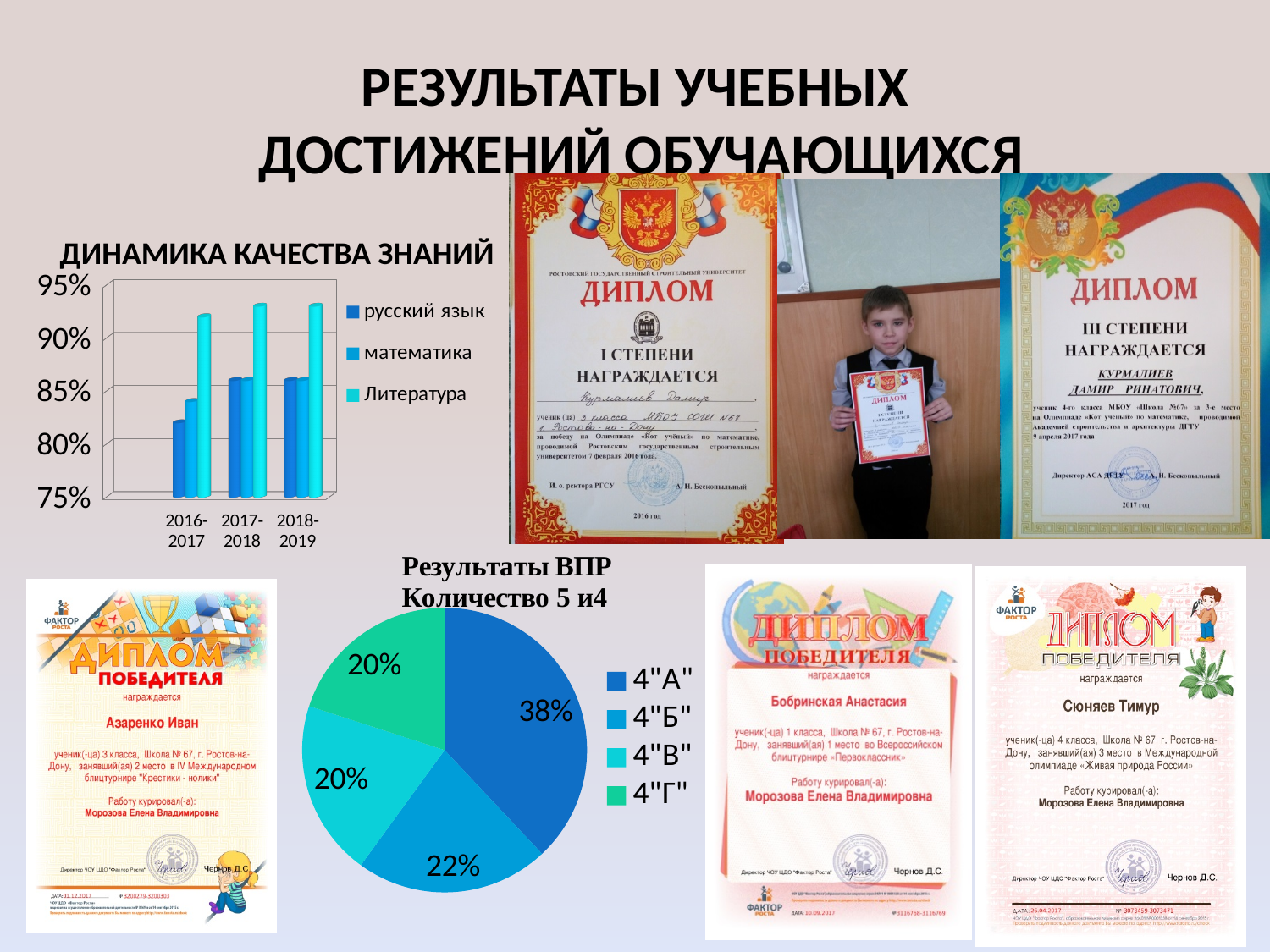
How many slices does the pie chart 'Результаты ВПР Количество 5 и4' have? 4 In the pie chart 'Результаты ВПР Количество 5 и4', what is the difference in percentage points between 4"А" and 4"Б"? 16 In the pie chart 'Результаты ВПР Количество 5 и4', which is larger, 4"А" or 4"Б"? 4"А" In the pie chart 'Результаты ВПР Количество 5 и4', what share does 4"А" have? 38% What kind of chart is 'ДИНАМИКА КАЧЕСТВА ЗНАНИЙ'? bar chart In the chart 'ДИНАМИКА КАЧЕСТВА ЗНАНИЙ', which subject has the highest value in 2016-2017? Литература In the pie chart 'Результаты ВПР Количество 5 и4', what share does 4"В" have? 20% In the chart 'ДИНАМИКА КАЧЕСТВА ЗНАНИЙ', is the value for Литература in 2016-2017 greater or less than 90%? greater In the pie chart 'Результаты ВПР Количество 5 и4', what share does 4"Б" have? 22% In the pie chart 'Результаты ВПР Количество 5 и4', which class has the largest share? 4"А" What kind of chart is 'Результаты ВПР Количество 5 и4'? pie chart How many series does the legend of the chart 'ДИНАМИКА КАЧЕСТВА ЗНАНИЙ' list? 3